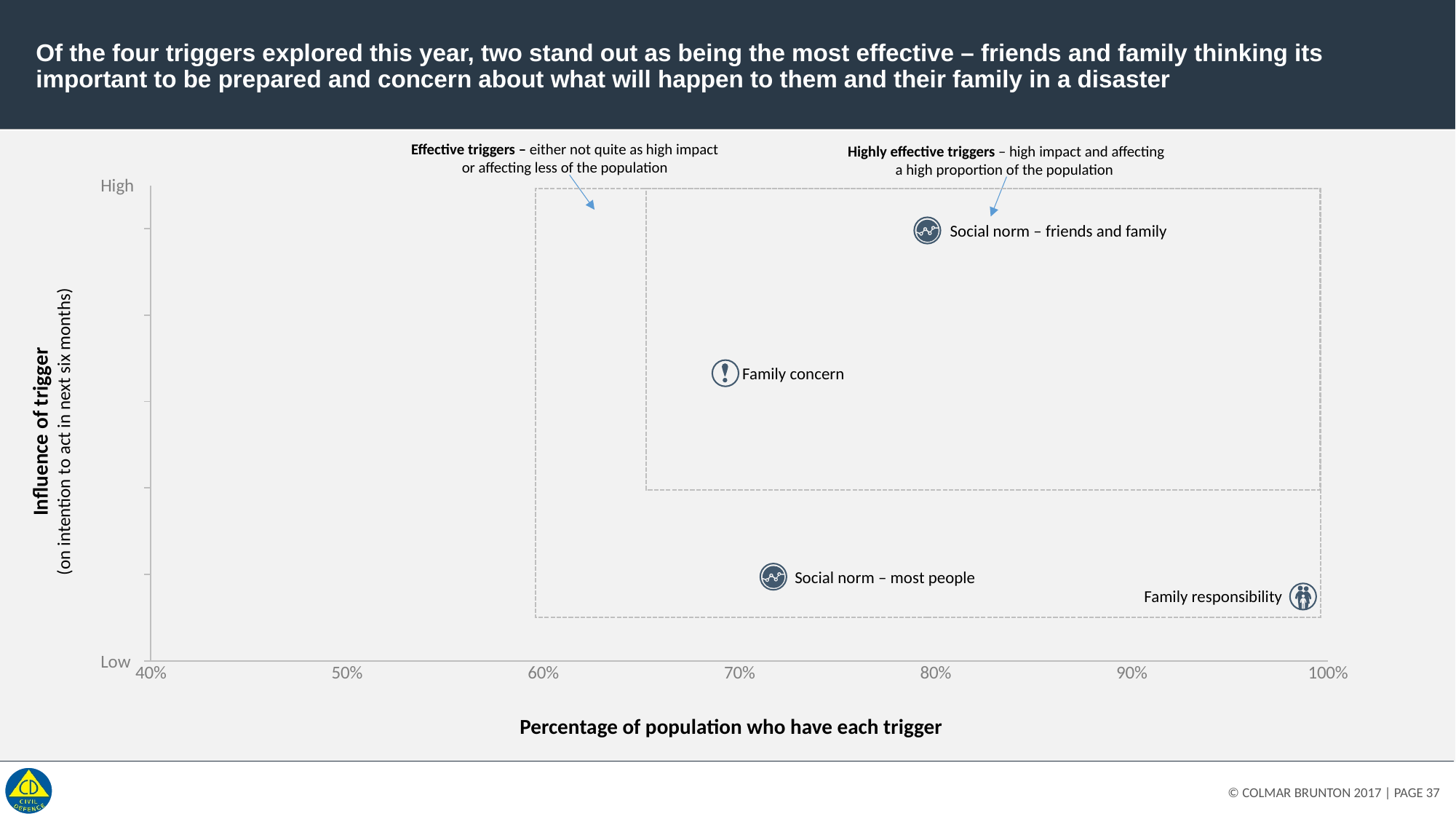
Which trigger has the highest influence on intention to act? Social norm – friends and family What kind of chart is shown on the slide? Scatter chart What is the title of the horizontal axis? Percentage of population who have each trigger Is the percentage of population for Family concern greater or less than 60%? greater Is the percentage of population for Social norm – most people greater or less than 80%? less Is the percentage of population for Family responsibility greater or less than 90%? greater Which two triggers fall inside the 'Highly effective triggers' box? Social norm – friends and family and Family concern Which has a higher influence of trigger: Social norm – friends and family or Social norm – most people? Social norm – friends and family Which is held by a larger percentage of the population: Family responsibility or Family concern? Family responsibility Which trigger is held by the highest percentage of the population? Family responsibility How many triggers are plotted on the chart? 4 Which trigger is held by the lowest percentage of the population? Family concern